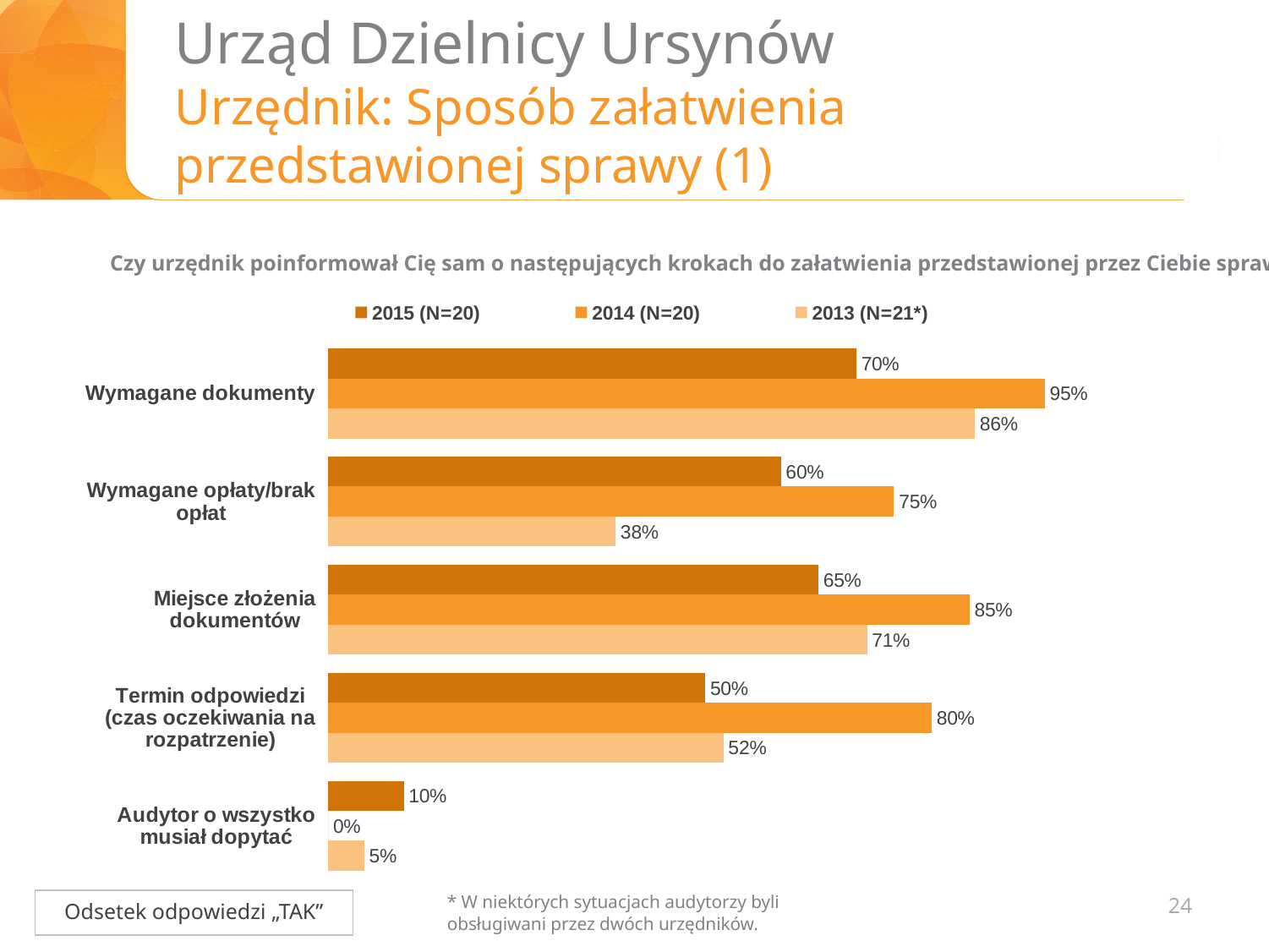
What does the box at the bottom left of the slide say the chart shows? Odsetek odpowiedzi „TAK” How many series does the legend list? 3 What is the difference between the 2014 (N=20) and 2015 (N=20) values for "Miejsce złożenia dokumentów"? 20% Which is larger for "Termin odpowiedzi (czas oczekiwania na rozpatrzenie)": the 2013 (N=21*) value or the 2015 (N=20) value? 2013 (N=21*) What is the value for "Wymagane dokumenty" in the 2014 (N=20) series? 95% Which category has the lowest value in the 2013 (N=21*) series? Audytor o wszystko musiał dopytać What is the value for "Wymagane opłaty/brak opłat" in the 2013 (N=21*) series? 38% Which category has the highest value in the 2015 (N=20) series? Wymagane dokumenty What kind of chart is shown on the slide? Bar chart What is the value for "Termin odpowiedzi (czas oczekiwania na rozpatrzenie)" in the 2015 (N=20) series? 50% What is the value for "Audytor o wszystko musiał dopytać" in the 2014 (N=20) series? 0% How many categories are shown on the chart? 5